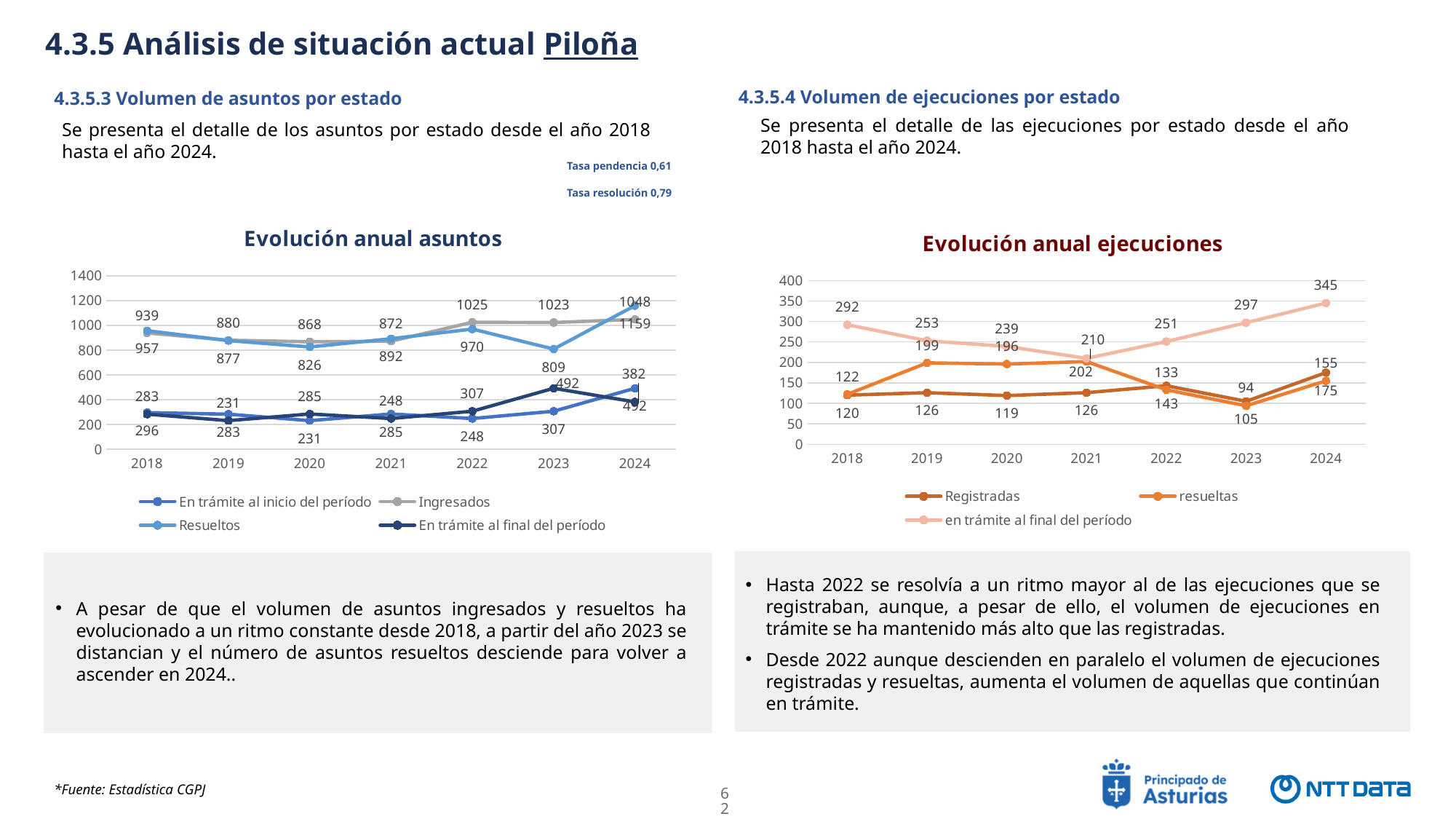
In the 'Evolución anual ejecuciones' chart, what is the difference between the 'en trámite al final del período' values for 2024 and 2018? 53 In the 'Evolución anual ejecuciones' chart, in which year is 'en trámite al final del período' lowest? 2021 In the 'Evolución anual asuntos' chart, what is the value of Ingresados in 2022? 1025 In the 'Evolución anual ejecuciones' chart, how many series does the legend list? 3 In the 'Evolución anual asuntos' chart, what is the value of Resueltos in 2023? 809 In the 'Evolución anual ejecuciones' chart, does 'en trámite al final del período' rise or fall from 2021 to 2024? Rise In the 'Evolución anual asuntos' chart, what is the difference between Ingresados and Resueltos in 2023? 214 In the 'Evolución anual asuntos' chart, what kind of chart is used? Line chart In the 'Evolución anual ejecuciones' chart, what is the value of 'en trámite al final del período' in 2024? 345 In the 'Evolución anual ejecuciones' chart, in which year is 'en trámite al final del período' highest? 2024 In the 'Evolución anual asuntos' chart, how many series does the legend list? 4 In the 'Evolución anual asuntos' chart, how many years are shown on the x axis? 7